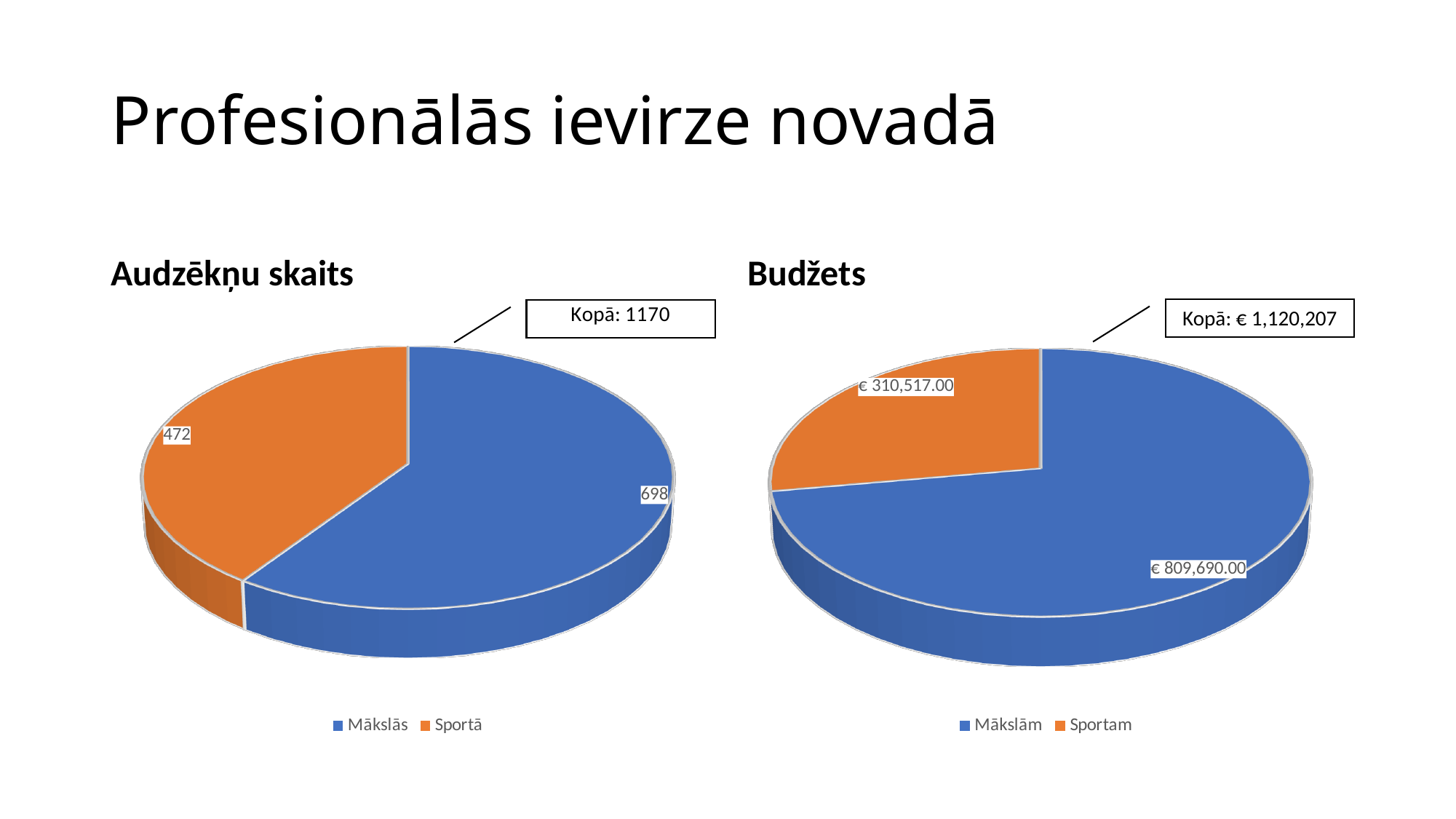
In the 'Audzēkņu skaits' chart, what is the difference between the Mākslās and Sportā values? 226 What total is shown in the callout box of the 'Audzēkņu skaits' chart? Kopā: 1170 How many entries does the legend of the 'Budžets' chart list? 2 In the 'Budžets' chart, what is the value for Mākslām? € 809,690.00 In the 'Budžets' chart, which category has the smallest slice? Sportam What total is shown in the callout box of the 'Budžets' chart? Kopā: € 1,120,207 In the 'Audzēkņu skaits' chart, which category has the largest slice? Mākslās In the 'Budžets' chart, is the value for Mākslām larger or smaller than the value for Sportam? larger In the 'Audzēkņu skaits' chart, what is the value for Sportā? 472 In the 'Budžets' chart, what is the value for Sportam? € 310,517.00 What kind of chart is the 'Budžets' chart? Pie chart In the 'Audzēkņu skaits' chart, what is the value for Mākslās? 698